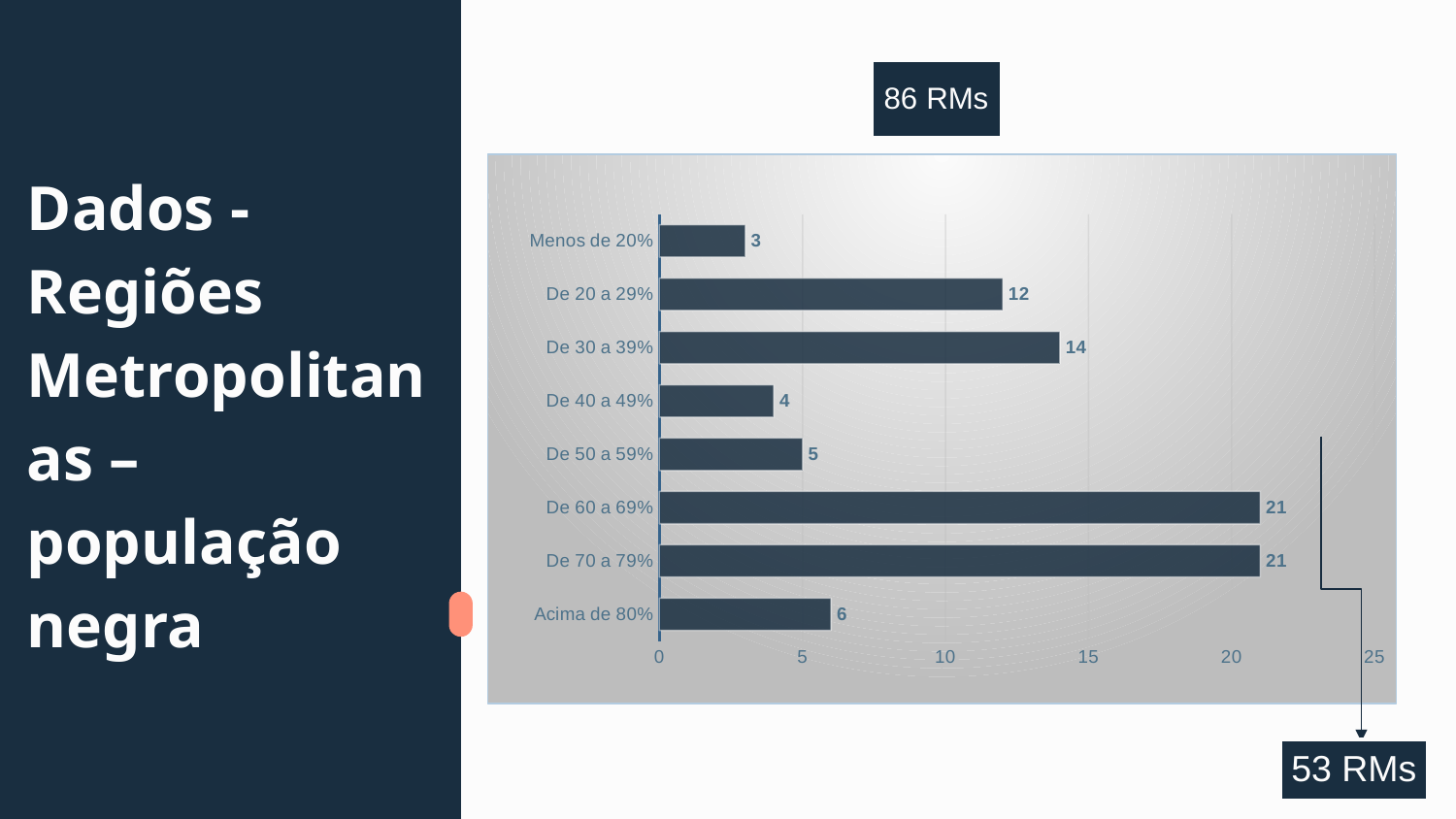
What is the value for the category 'Acima de 80%'? 6 Is the value for 'De 60 a 69%' greater or less than 20? greater Which is larger, the value for 'De 50 a 59%' or the value for 'Acima de 80%'? Acima de 80% What is the difference between the values for 'De 20 a 29%' and 'De 40 a 49%'? 8 What is the value for the category 'De 70 a 79%'? 21 How many categories are shown in the chart? 8 What kind of chart is shown on the slide? bar chart Which category has the lowest value? Menos de 20% What label appears in the box above the chart? 86 RMs What is the value for the category 'Menos de 20%'? 3 What is the value for the category 'De 30 a 39%'? 14 What is the highest value shown on the x axis? 25